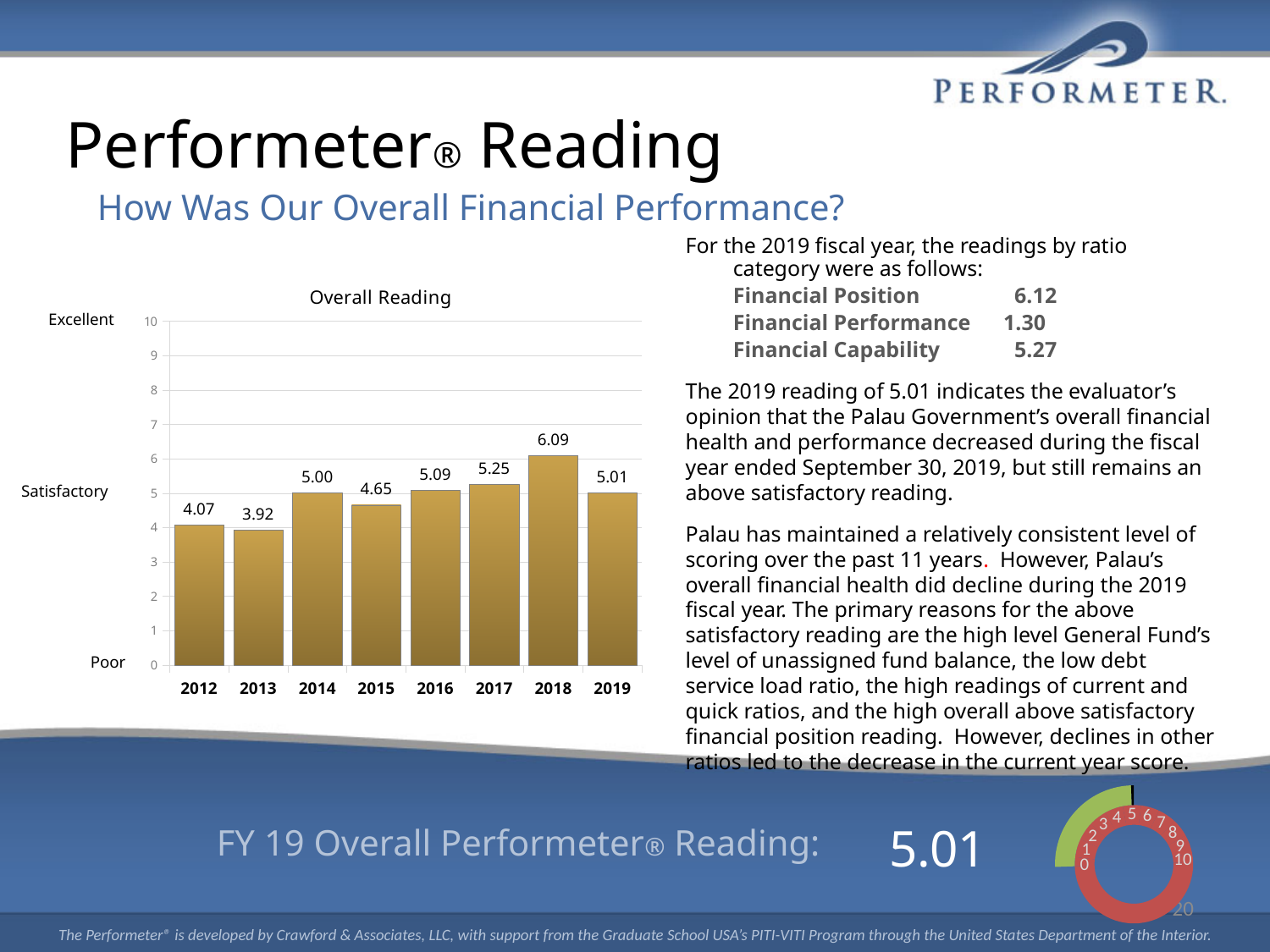
Did the Overall Reading rise or fall from 2018 to 2019? fall Which year has a higher Overall Reading, 2014 or 2015? 2014 What is the Overall Reading value for 2018? 6.09 What label appears at the top of the y axis of the Overall Reading chart, next to the value 10? Excellent How many years are shown in the Overall Reading chart? 8 What is the Overall Reading value for 2019? 5.01 What kind of chart is the Overall Reading chart? bar chart What is the Overall Reading value for 2013? 3.92 Which year has the lowest Overall Reading? 2013 Is the Overall Reading for 2012 greater or less than 5? less Which year has the highest Overall Reading? 2018 What is the difference between the Overall Reading for 2018 and 2019? 1.08